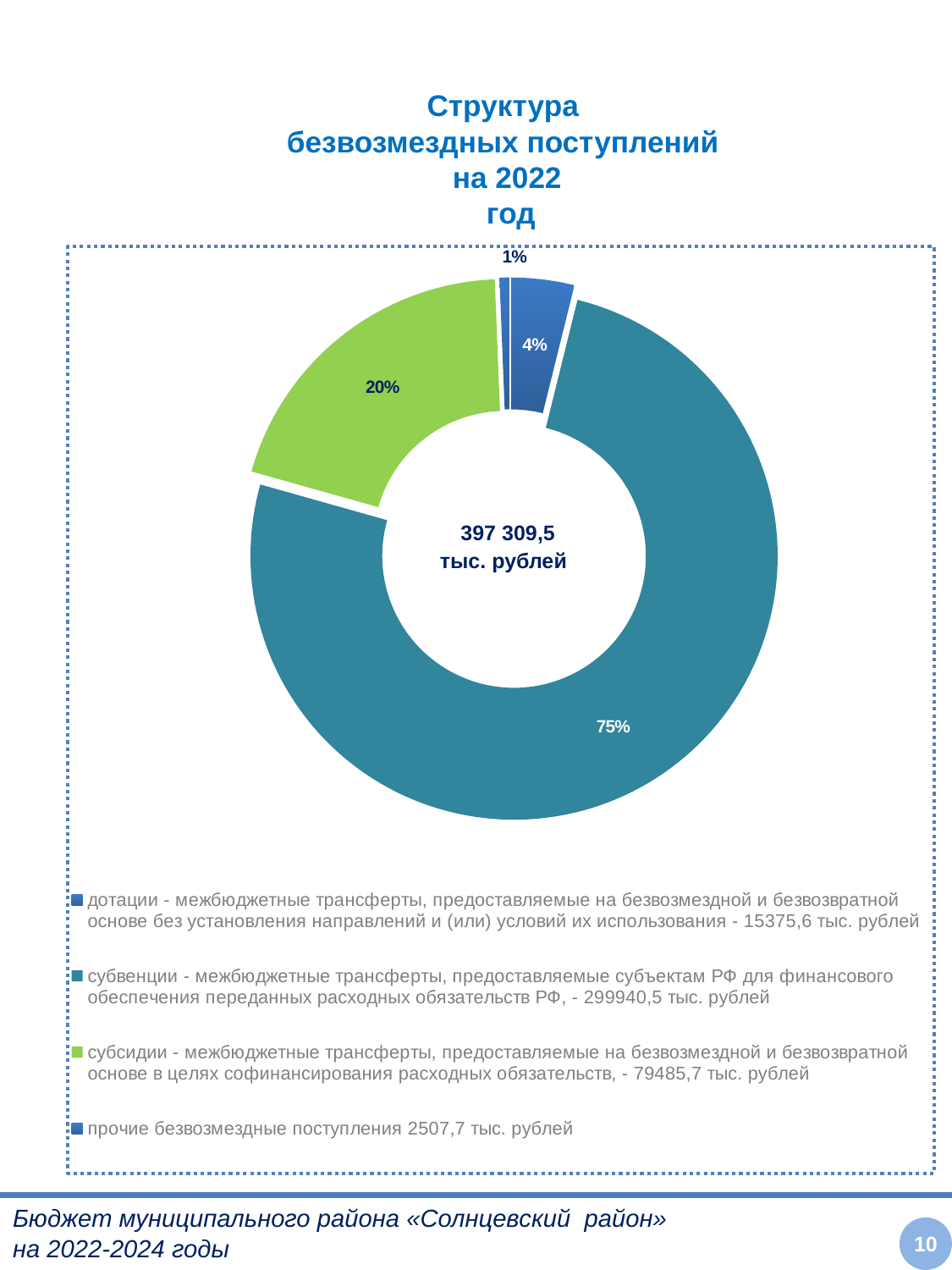
What share of the chart does субвенции (subventions) account for? 75% Which is larger: the share for дотации or the share for субсидии? субсидии What is the difference in percentage points between the субвенции share and the субсидии share? 55 percentage points According to the legend, what is the amount for субвенции? 299940,5 тыс. рублей Which category has the largest share of the chart? субвенции Which category has the smallest share of the chart? прочие безвозмездные поступления What share of the chart does прочие безвозмездные поступления (other gratuitous receipts) account for? 1% How many categories does the legend list? 4 What share of the chart does дотации (grants) account for? 4% What total amount is shown in the centre of the chart? 397 309,5 тыс. рублей What kind of chart is shown on the slide? Doughnut (pie) chart